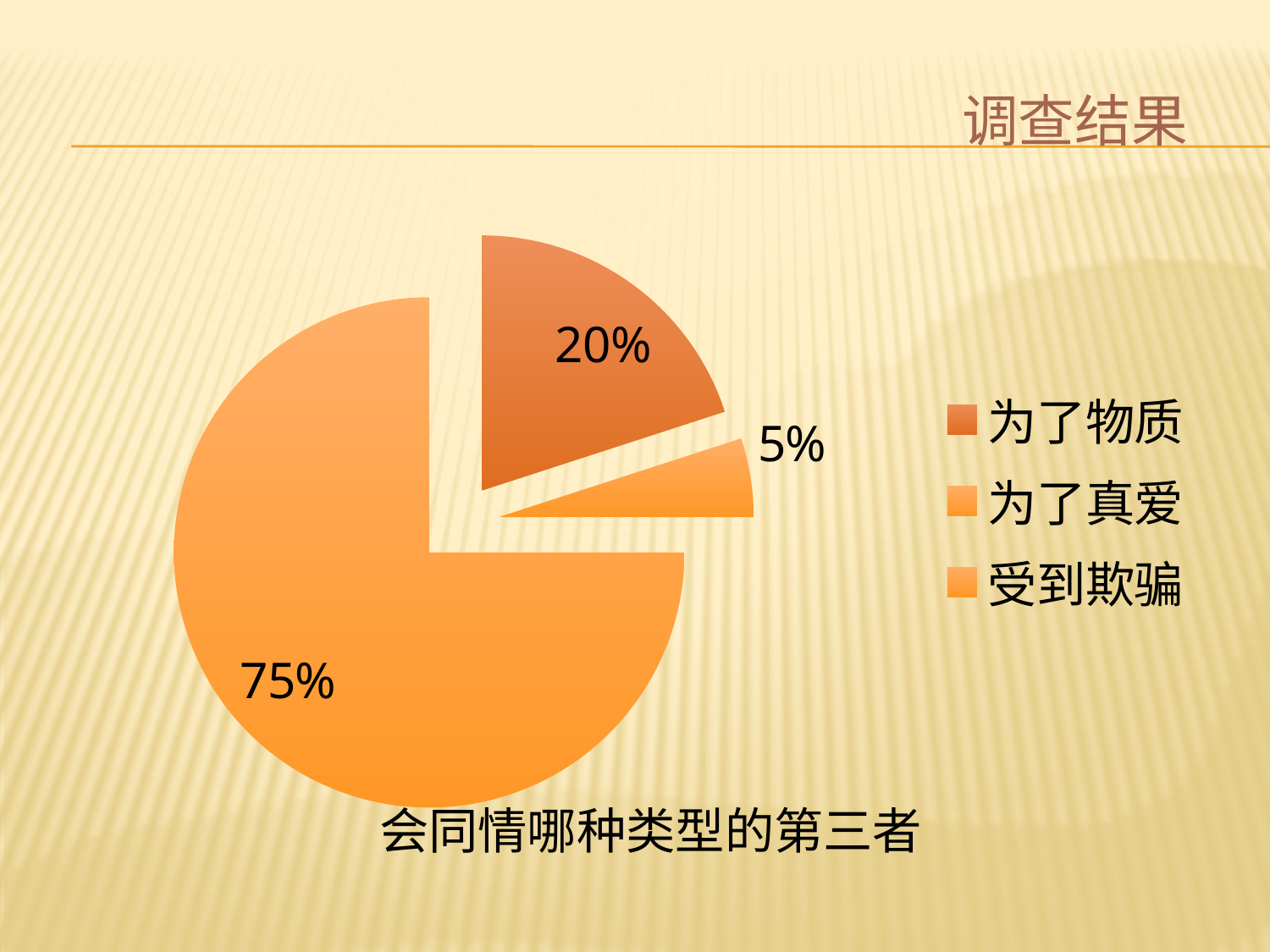
What is the value for 为了物质? 20% What share of the pie does 受到欺骗 take? 75% What is the difference between the values for 受到欺骗 and 为了物质? 55% Which is larger, the value for 为了物质 or the value for 为了真爱? 为了物质 Which category has the smallest slice? 为了真爱 What is the title of the chart? 会同情哪种类型的第三者 What is the value for 受到欺骗? 75% What is the value for 为了真爱? 5% Which category has the largest slice? 受到欺骗 How many categories does the pie chart have? 3 What is the difference between the values for 为了物质 and 为了真爱? 15% What kind of chart is shown on the slide? pie chart